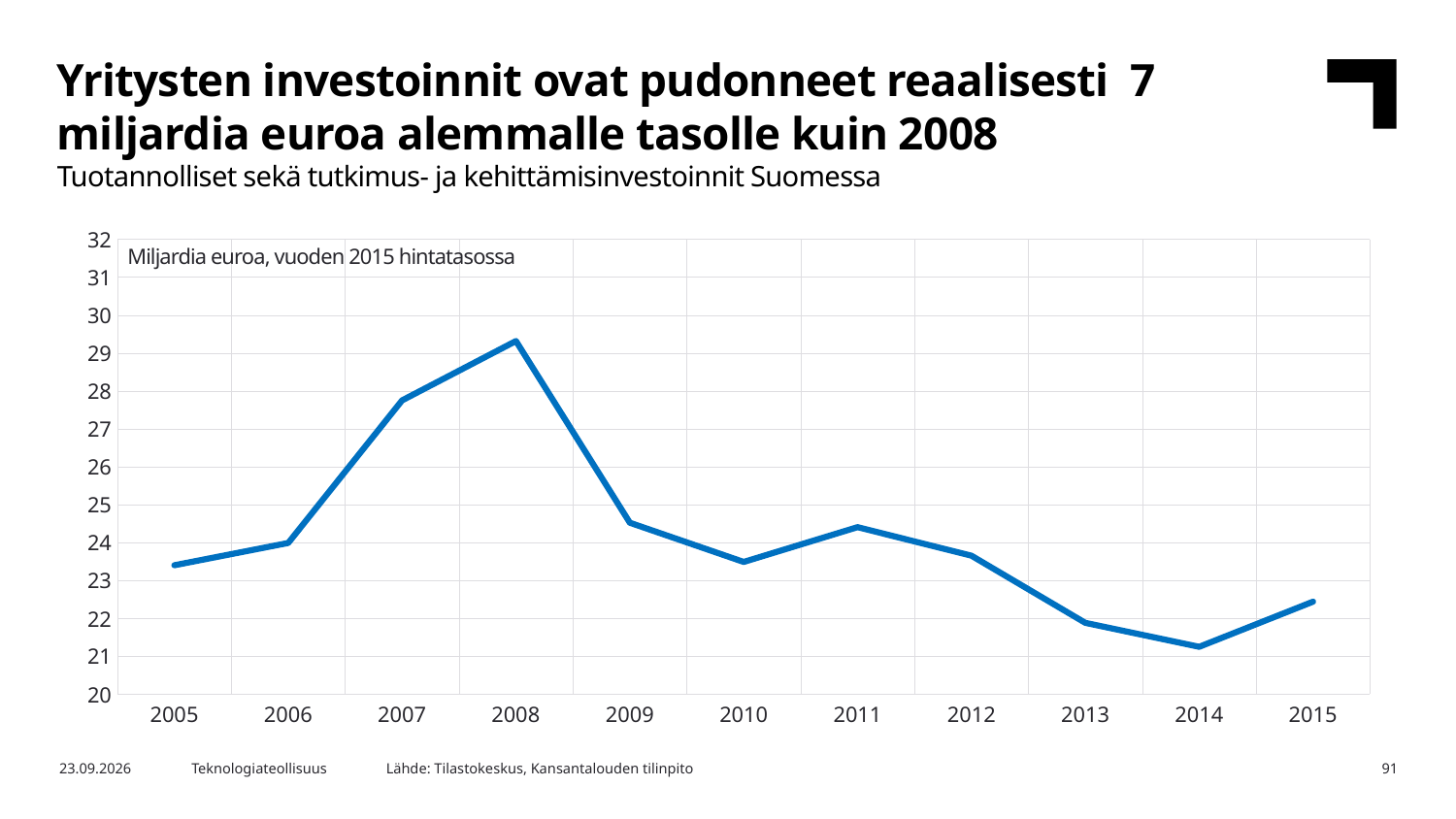
How many years are plotted on the x axis? 11 Do the values rise or fall from 2008 to 2014? fall Is the value for 2014 greater or less than 22? less Which year has the highest value on the chart? 2008 What unit is stated in the label inside the chart area? Miljardia euroa, vuoden 2015 hintatasossa Is the value for 2007 greater or less than 27? greater Is the value for 2008 greater or less than 28? greater Which year has the lowest value on the chart? 2014 Which year has the larger value, 2013 or 2006? 2006 Which year has the larger value, 2007 or 2010? 2007 What kind of chart is shown on the slide? line chart